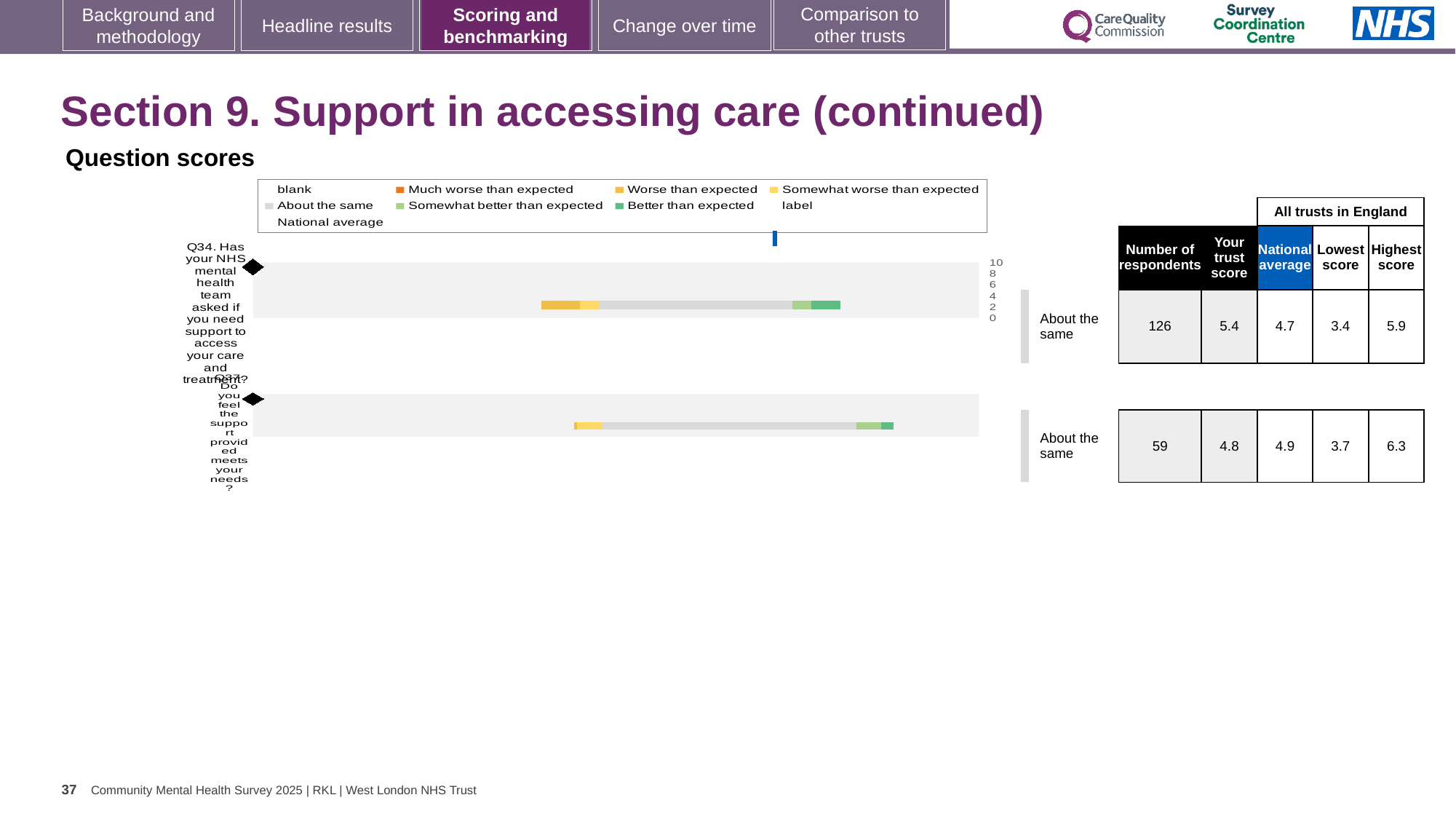
What kind of chart is used to show the question scores on this slide? bar chart What is the national average for Q34 (Has your NHS mental health team asked if you need support to access your care and treatment?)? 4.7 What is the trust score for Q37 (Do you feel the support provided meets your needs?)? 4.8 How many more respondents answered Q34 than Q37? 67 What is the number of respondents for Q34 in the question scores table? 126 What is the difference between the highest and lowest scores for Q37? 2.6 For Q34, is the trust score or the national average higher? Your trust score How many questions are plotted in the question scores chart? 2 Which question has more respondents, Q34 or Q37? Q34 What is the highest score across all trusts in England for Q37? 6.3 What benchmarking category is shown next to the bar for Q37? About the same What is the lowest score across all trusts in England for Q34? 3.4